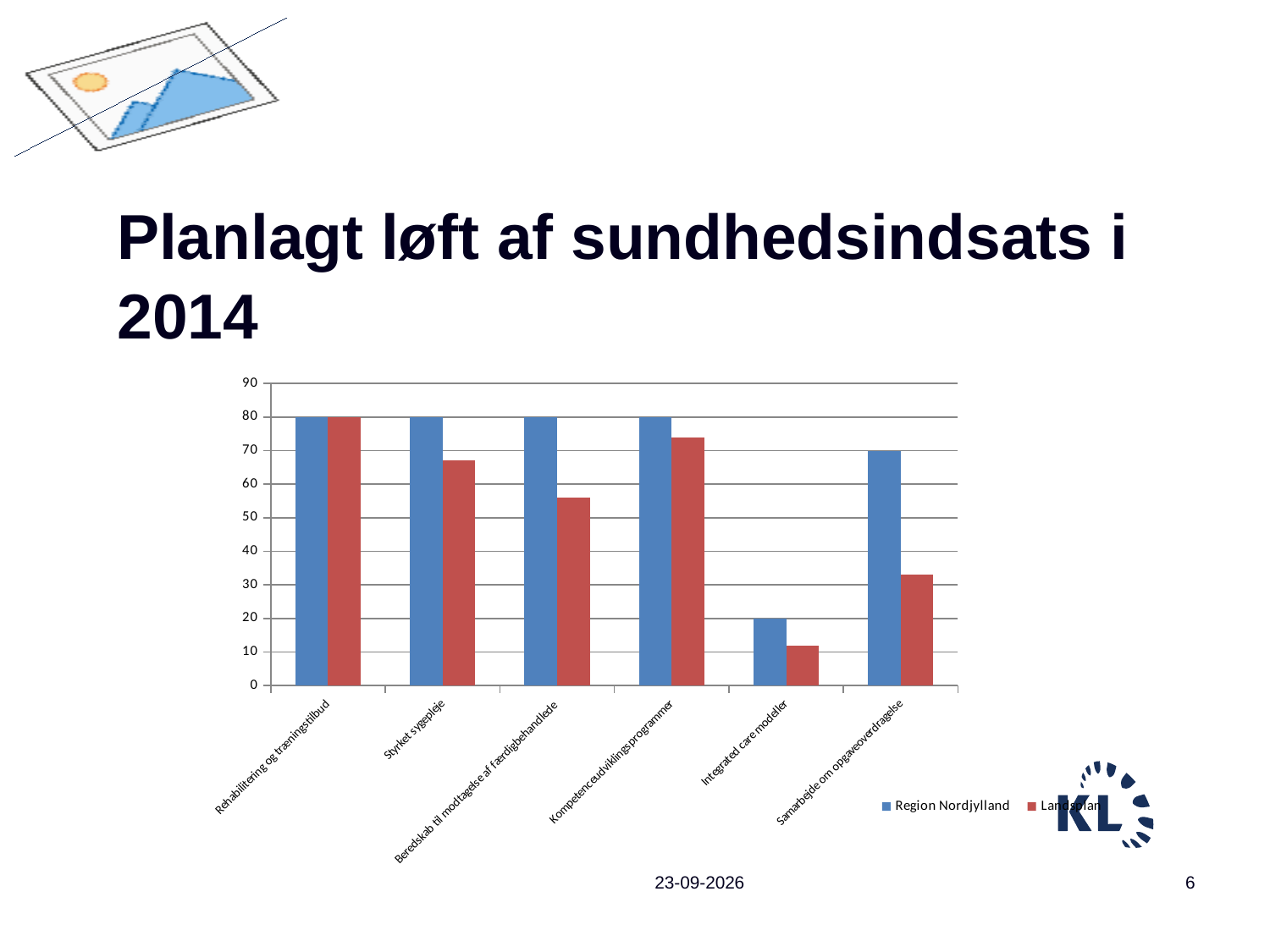
What is the value for Region Nordjylland in the category Samarbejde om opgaveoverdragelse? 70 What is the difference between the Region Nordjylland values for Rehabilitering og træningstilbud and Integrated care modeller? 60 What kind of chart is shown on the slide? bar chart Which category has the lowest value for Region Nordjylland? Integrated care modeller What is the value for Region Nordjylland in the category Integrated care modeller? 20 How many categories are shown on the x axis of the chart? 6 Is the value for Landsplan in Samarbejde om opgaveoverdragelse greater or less than 40? less What is the value for Landsplan in the category Rehabilitering og træningstilbud? 80 Is the value for Landsplan in Styrket sygepleje greater or less than 60? greater In the category Beredskab til modtagelse af færdigbehandlede, which series has the larger value, Region Nordjylland or Landsplan? Region Nordjylland How many series does the chart's legend list? 2 Which category has the highest value for Landsplan? Rehabilitering og træningstilbud